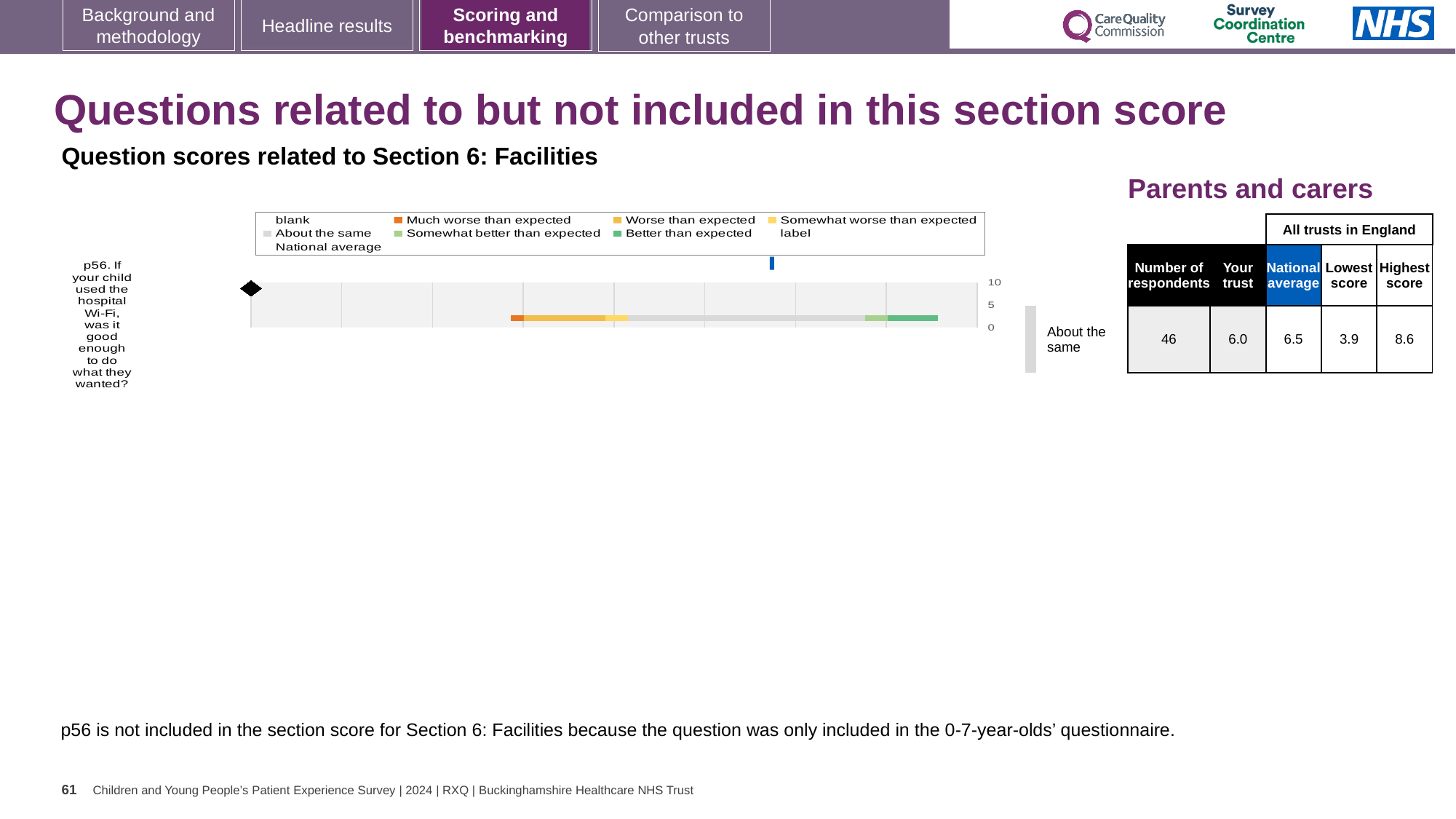
What is the lowest score among all trusts in England for question p56? 3.9 What kind of chart is used to show the benchmarking result for question p56? bar chart How many questions are plotted on the benchmarking chart? 1 What colour does the legend use for 'Much worse than expected'? orange What is the number of respondents for question p56? 46 What is the national average score for question p56? 6.5 Which is larger for question p56, the 'Your trust' score or the national average? National average What is the highest score among all trusts in England for question p56? 8.6 What is the 'Your trust' score for question p56? 6.0 Which question is plotted on the benchmarking chart? p56. If your child used the hospital Wi-Fi, was it good enough to do what they wanted? What benchmarking category label is shown next to the chart for question p56? About the same What is the difference between the highest score and the lowest score for question p56? 4.7